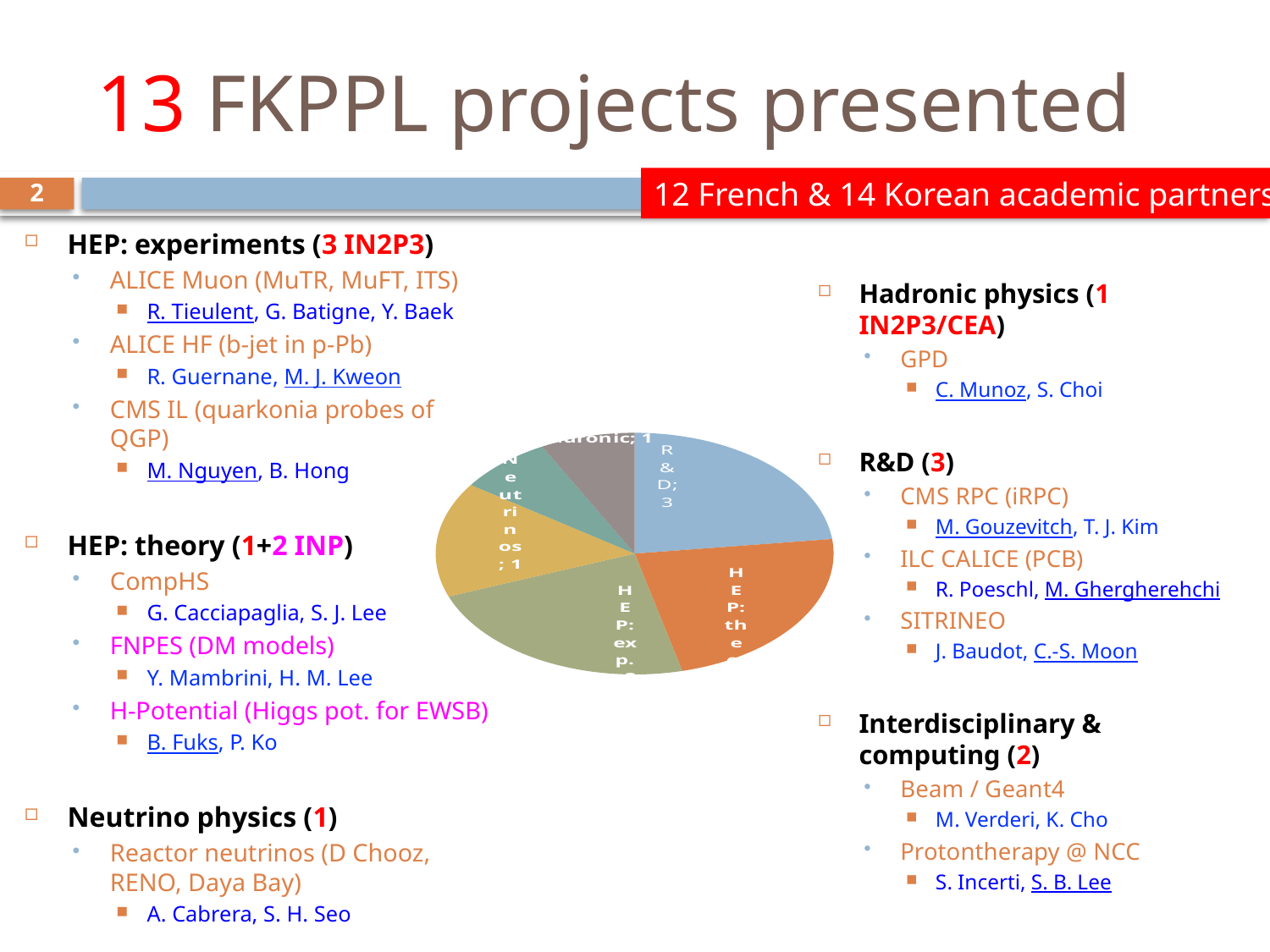
How many slices does the pie chart have? 6 What colour is the R&D slice in the pie chart? blue In the pie chart, what value is shown for the Neutrinos slice? 1 In the pie chart, which is larger, the HEP: exp. slice or the Hadronic slice? HEP: exp. In the pie chart, which is larger, the R&D slice or the Neutrinos slice? R&D In the pie chart, what is the difference between the R&D value and the Neutrinos value? 2 In the pie chart, what value is shown for the Hadronic slice? 1 What kind of chart is shown on the slide? pie chart In the pie chart, what value is shown for the R&D slice? 3